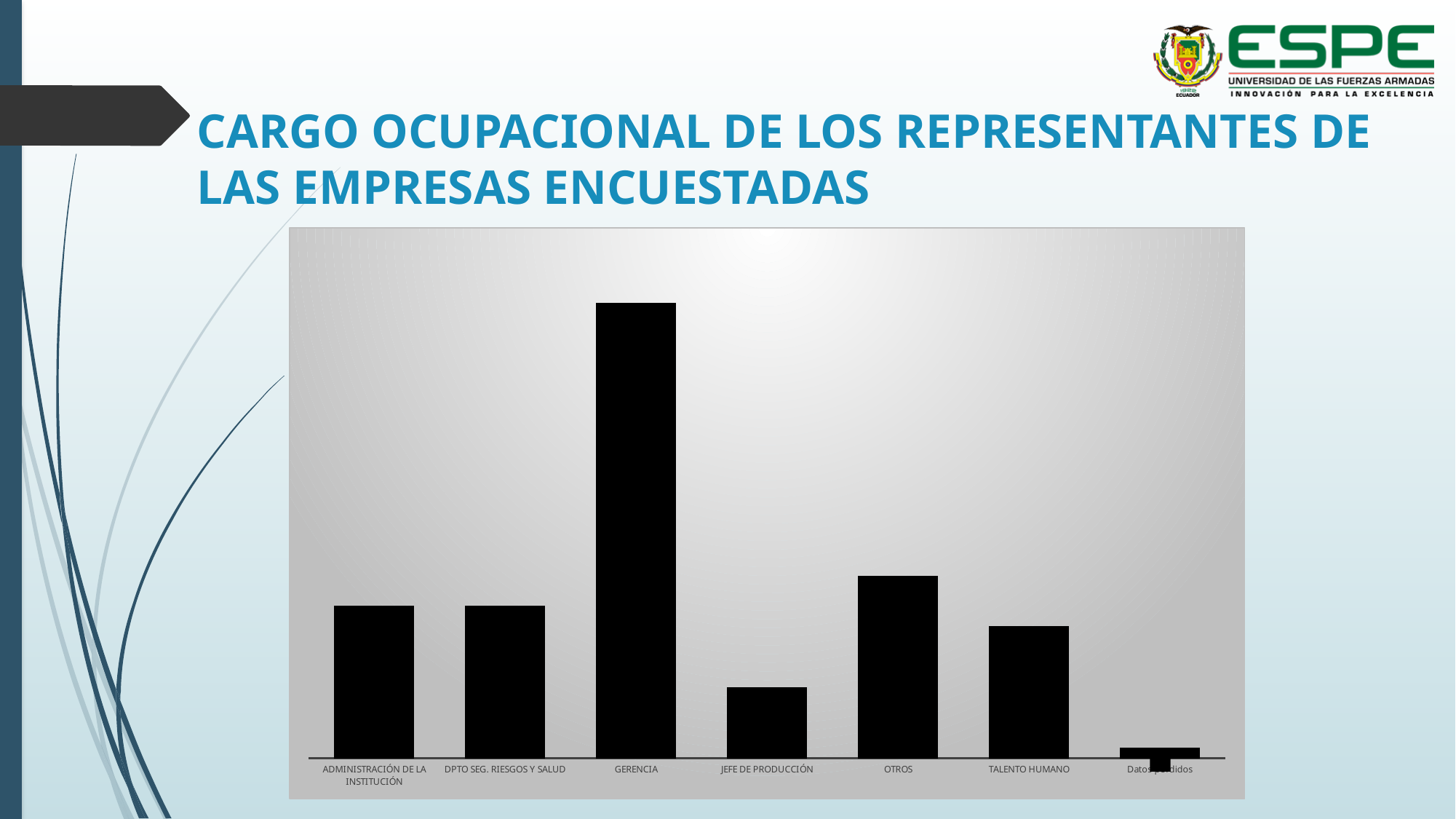
Which is larger, the value for GERENCIA or the value for OTROS? GERENCIA Which category has the highest bar in the chart? GERENCIA What is the title of the slide containing the chart? CARGO OCUPACIONAL DE LOS REPRESENTANTES DE LAS EMPRESAS ENCUESTADAS Which category has the second highest bar in the chart? OTROS What colour are the bars in the chart? Black What kind of chart is shown on the slide? Bar chart Which is larger, the value for JEFE DE PRODUCCIÓN or the value for DPTO SEG. RIESGOS Y SALUD? DPTO SEG. RIESGOS Y SALUD Which category has the lowest bar in the chart? Datos perdidos Which is larger, the value for OTROS or the value for TALENTO HUMANO? OTROS How many categories (bars) does the chart show? 7